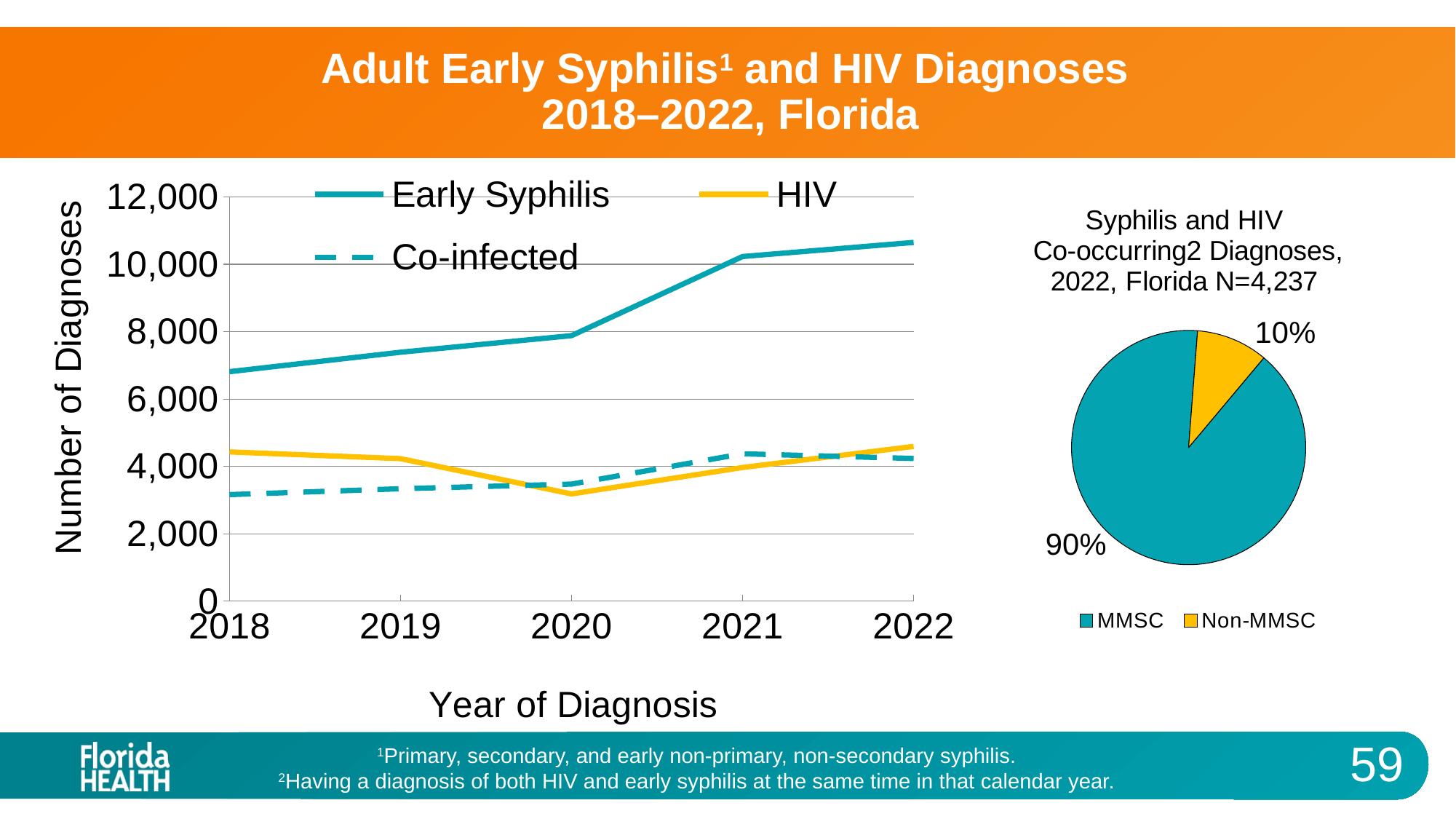
In the left line chart, which series is higher in 2018, HIV or Co-infected? HIV In the right pie chart, what share of co-occurring diagnoses is Non-MMSC? 10% In the left line chart, is the HIV value for 2020 greater or less than 4,000? less In the left line chart, how many series does the legend list? 3 In the right pie chart, what is the total N given in the chart title? 4,237 In the left line chart, is the Early Syphilis value for 2018 greater or less than 6,000? greater In the left line chart, is the Early Syphilis value for 2022 greater or less than 10,000? greater In the left line chart, how many years are shown on the x axis? 5 In the left line chart, do Early Syphilis diagnoses rise or fall from 2018 to 2022? rise In the right pie chart, what share of co-occurring diagnoses is MMSC? 90% What kind of chart is the right chart titled 'Syphilis and HIV Co-occurring Diagnoses, 2022, Florida'? pie chart What kind of chart is the left chart showing Early Syphilis, HIV and Co-infected diagnoses? line chart